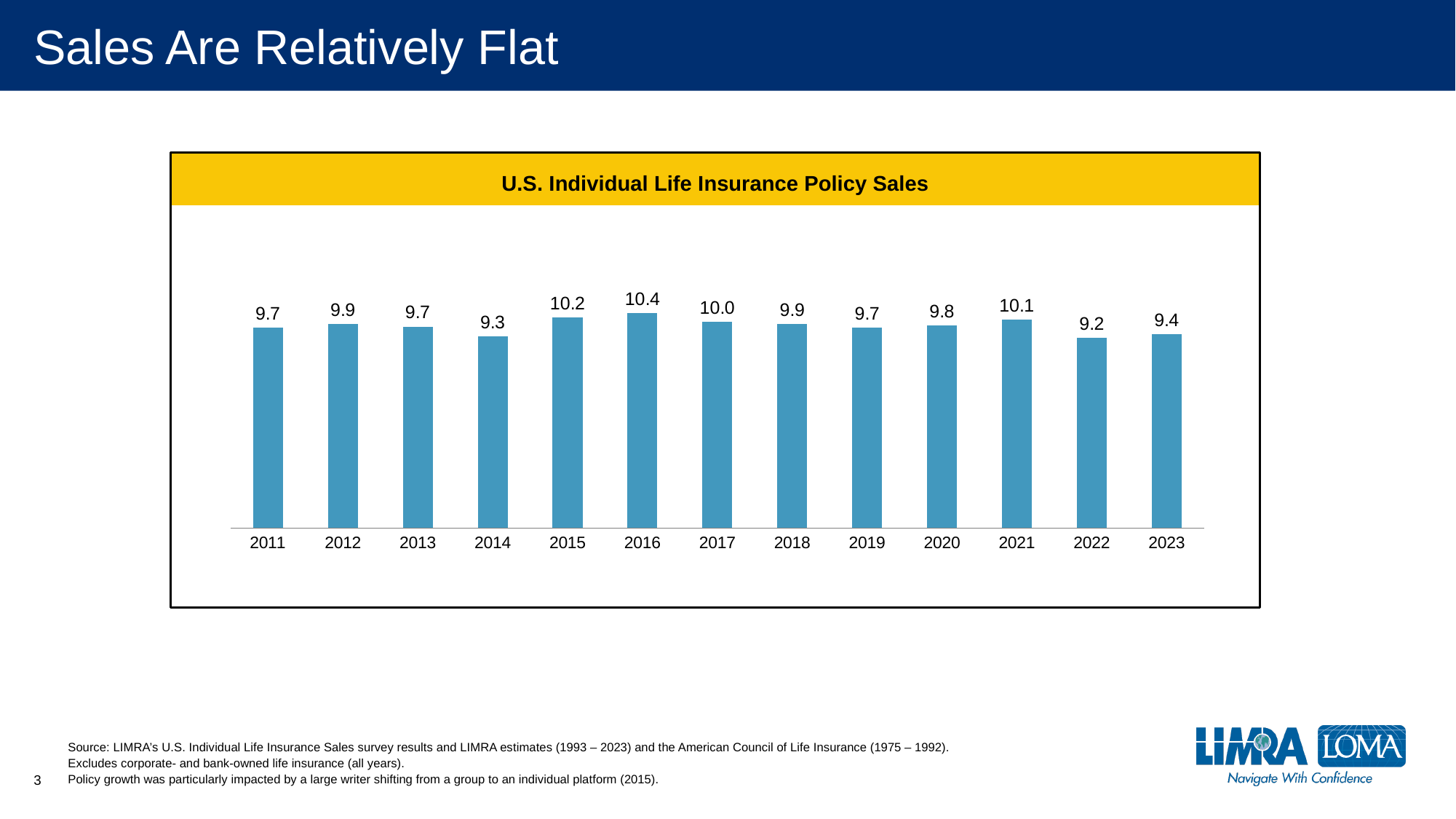
Which year has the highest value? 2016 Which is larger, the value for 2021 or the value for 2023? 2021 What is the title of the chart? U.S. Individual Life Insurance Policy Sales What is the difference between the values for 2016 and 2022? 1.2 What is the value for 2014? 9.3 How many years are shown on the chart? 13 What kind of chart is shown? bar chart What is the value for 2016? 10.4 Which year has the lowest value? 2022 What is the value for 2022? 9.2 What is the value for 2023? 9.4 Do the values rise or fall from 2021 to 2022? fall